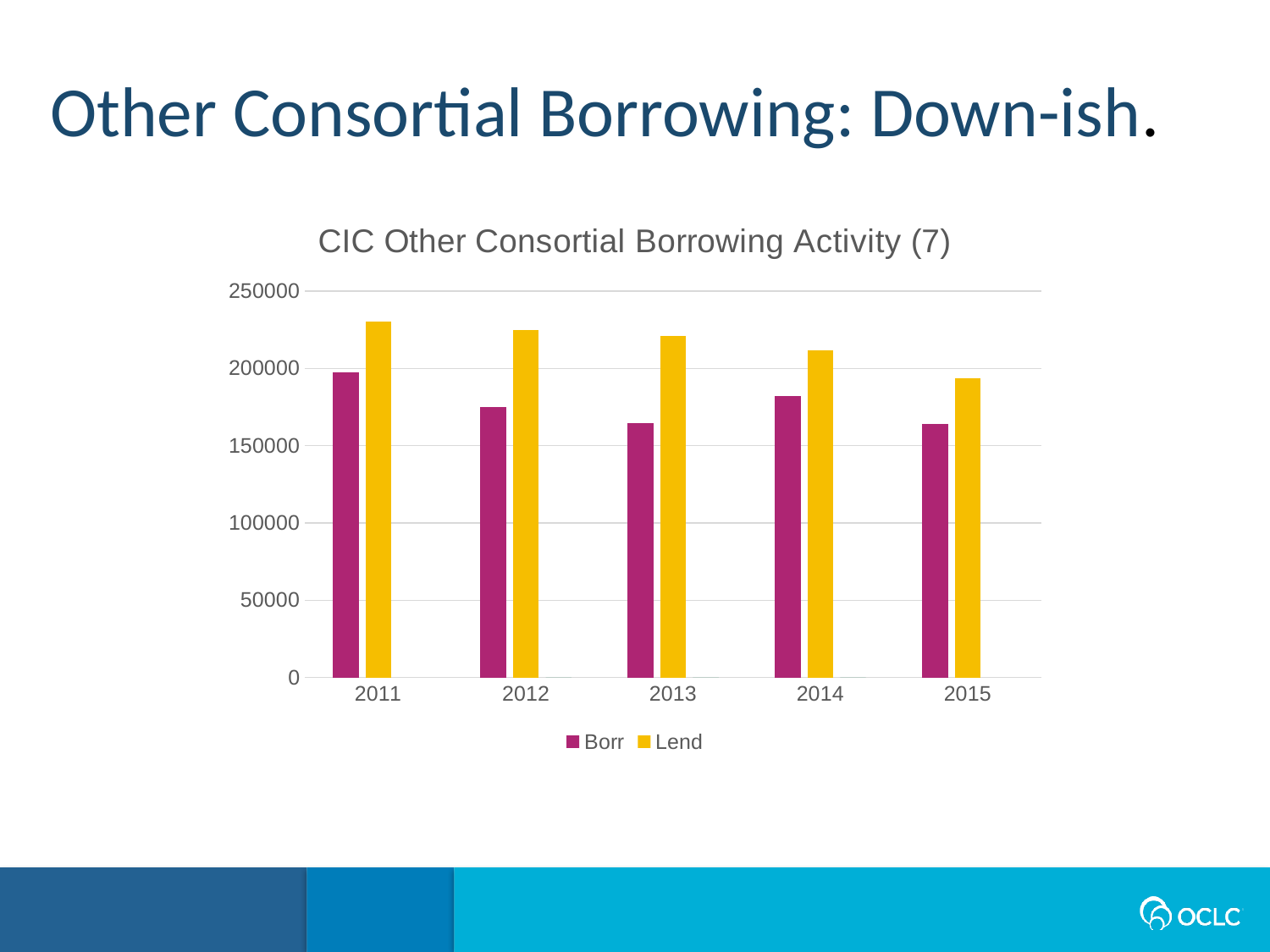
What kind of chart is shown on the slide? Bar chart Is the Lend value for 2015 greater or less than 200000? less How many years are shown on the x axis? 5 Is the Borr value for 2013 greater or less than 150000? greater Do the Lend values rise or fall from 2011 to 2015? Fall How many series does the legend list? 2 In 2013, which is larger, Borr or Lend? Lend Which is larger, the Borr value for 2011 or the Borr value for 2015? 2011 What is the title of the chart? CIC Other Consortial Borrowing Activity (7) Which year has the lowest Lend value? 2015 Is the Lend value for 2011 greater or less than 200000? greater Which year has the highest Borr value? 2011